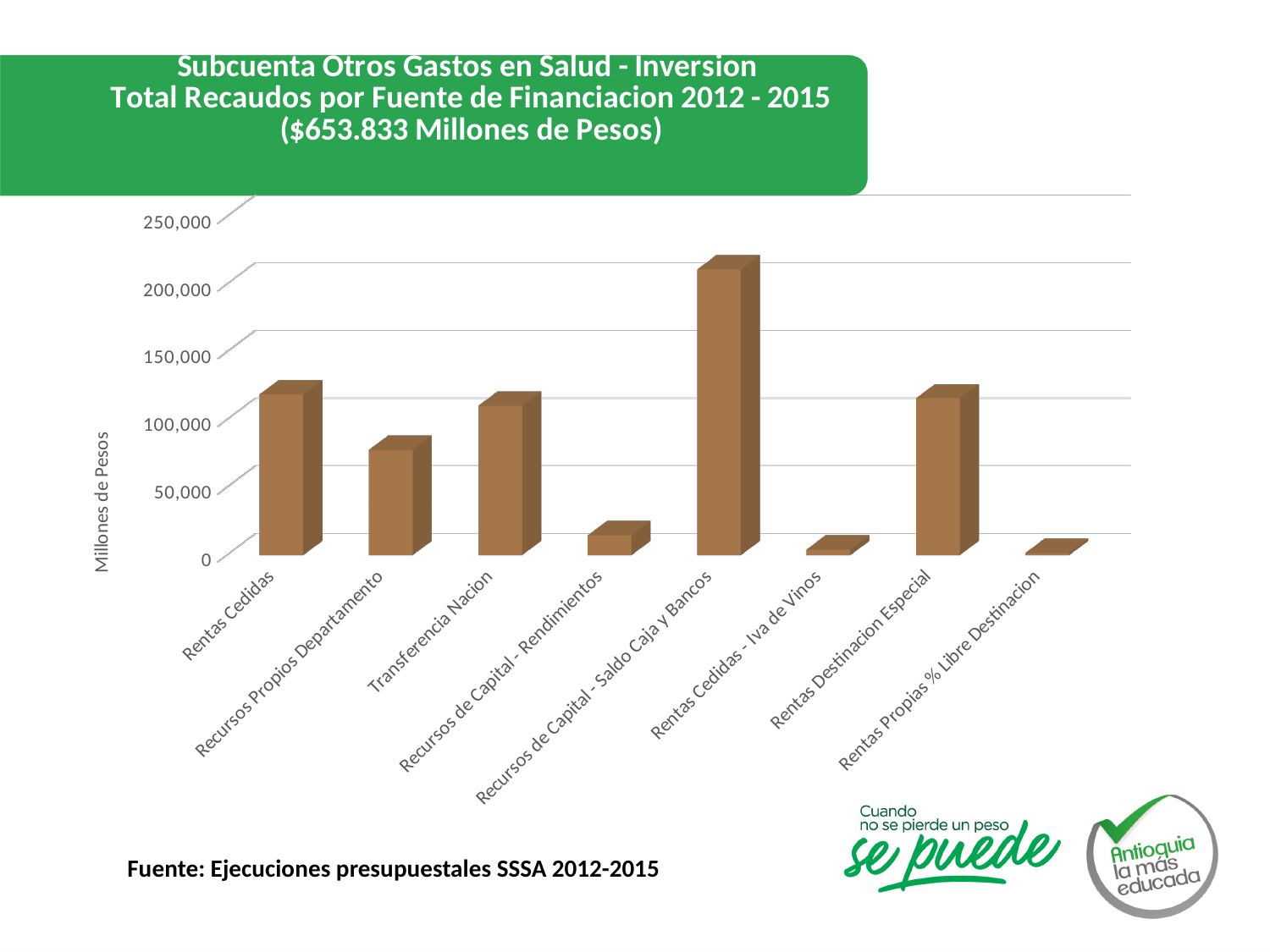
Is the value for Recursos Propios Departamento greater or less than 100,000? less According to the chart title, what is the total recaudos for 2012 - 2015? $653.833 Millones de Pesos What kind of chart is shown on the slide? bar chart Which is larger, the value for Rentas Cedidas or the value for Recursos Propios Departamento? Rentas Cedidas What is the label of the vertical axis? Millones de Pesos Is the value for Recursos de Capital - Rendimientos greater or less than 50,000? less Is the value for Rentas Destinacion Especial greater or less than 100,000? greater Which funding source has the highest total recaudos? Recursos de Capital - Saldo Caja y Bancos How many funding sources (categories) are plotted on the x axis? 8 Which is larger, the value for Recursos de Capital - Rendimientos or the value for Rentas Cedidas - Iva de Vinos? Recursos de Capital - Rendimientos